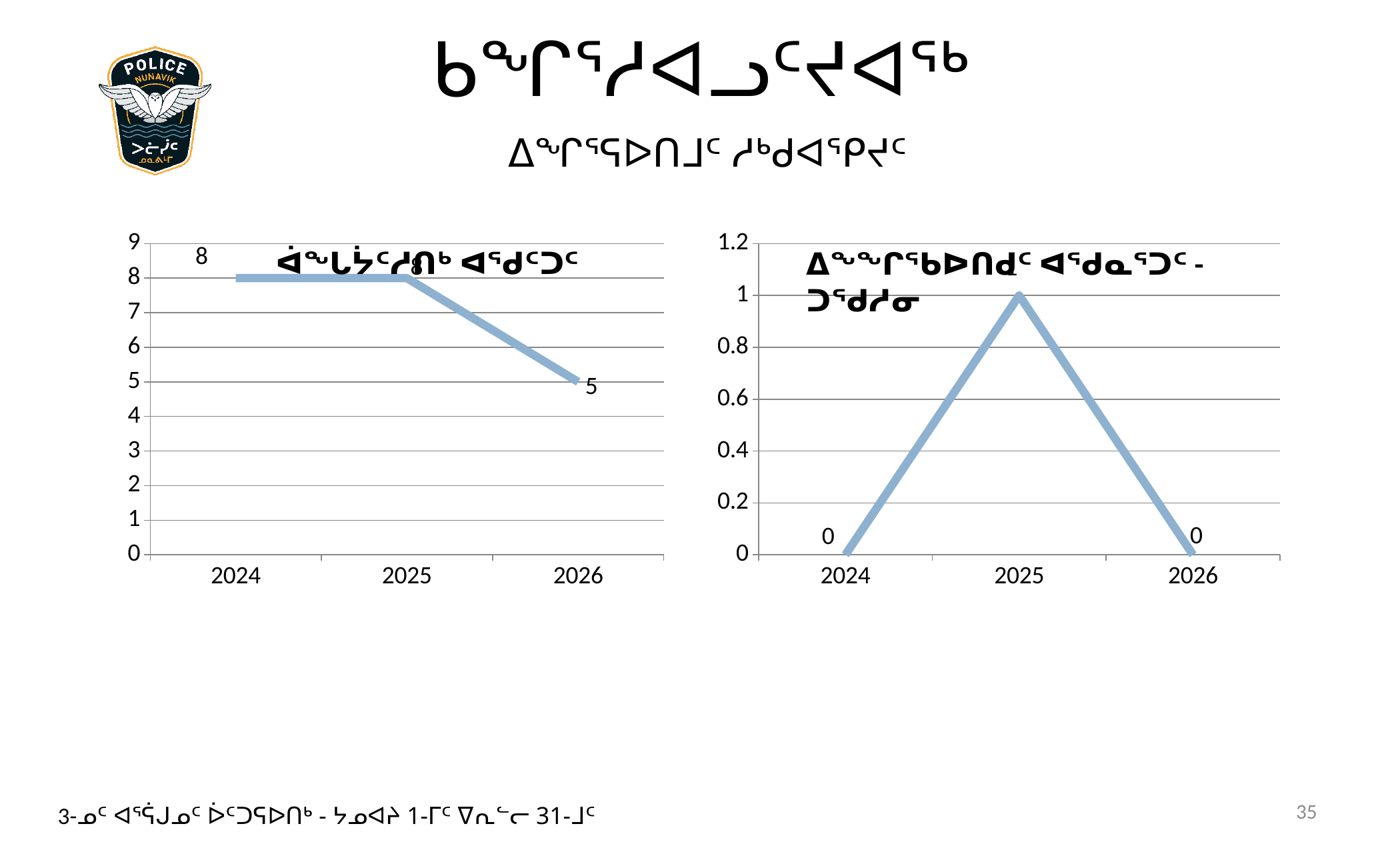
In the right chart, what is the value for 2024? 0 In the left chart, do the values rise or fall from 2025 to 2026? fall How many years are plotted in the left chart? 3 In the right chart, which year has the highest value? 2025 What kind of chart is the right chart? line chart In the left chart, what is the value for 2024? 8 What kind of chart is the left chart? line chart In the left chart, what is the difference between the values for 2024 and 2026? 3 In the right chart, what is the value for 2025? 1 In the left chart, what is the value for 2026? 5 In the left chart, which year has the lowest value? 2026 In the right chart, is the value for 2025 greater or less than 0.6? greater